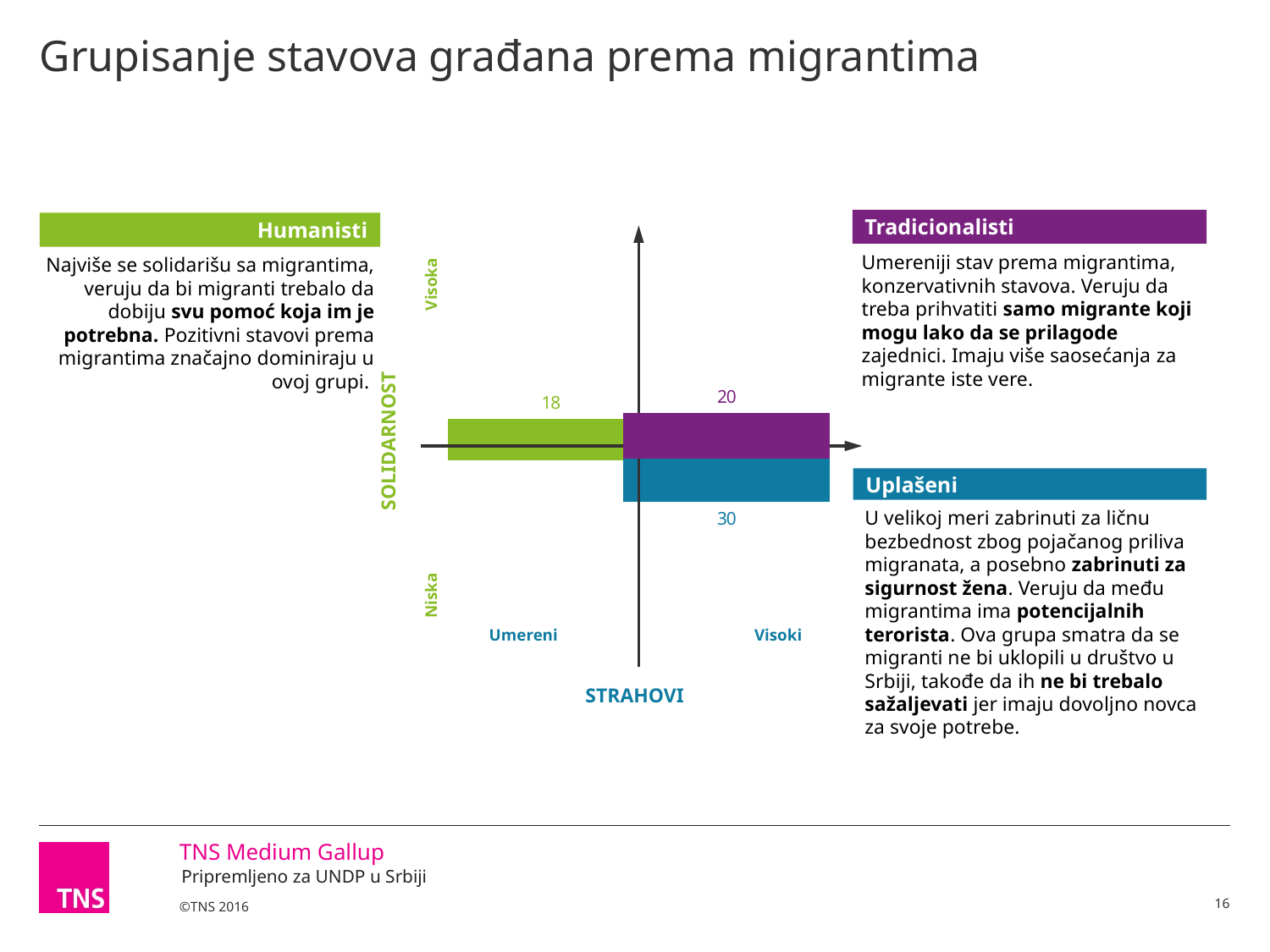
What is the value shown for the Humanisti group? 18 Which group has the highest value on the chart? Uplašeni What is the value shown for the Tradicionalisti group? 20 Which group has the lowest value on the chart? Humanisti Which is larger, the value for Uplašeni or the value for Tradicionalisti? Uplašeni What is the difference between the values for Tradicionalisti and Humanisti? 2 What is the label of the horizontal axis of the chart? STRAHOVI What is the total of the three values shown on the chart? 68 What is the label of the vertical axis of the chart? SOLIDARNOST What is the value shown for the Uplašeni group? 30 What is the difference between the values for Uplašeni and Humanisti? 12 How many groups are plotted on the chart? 3